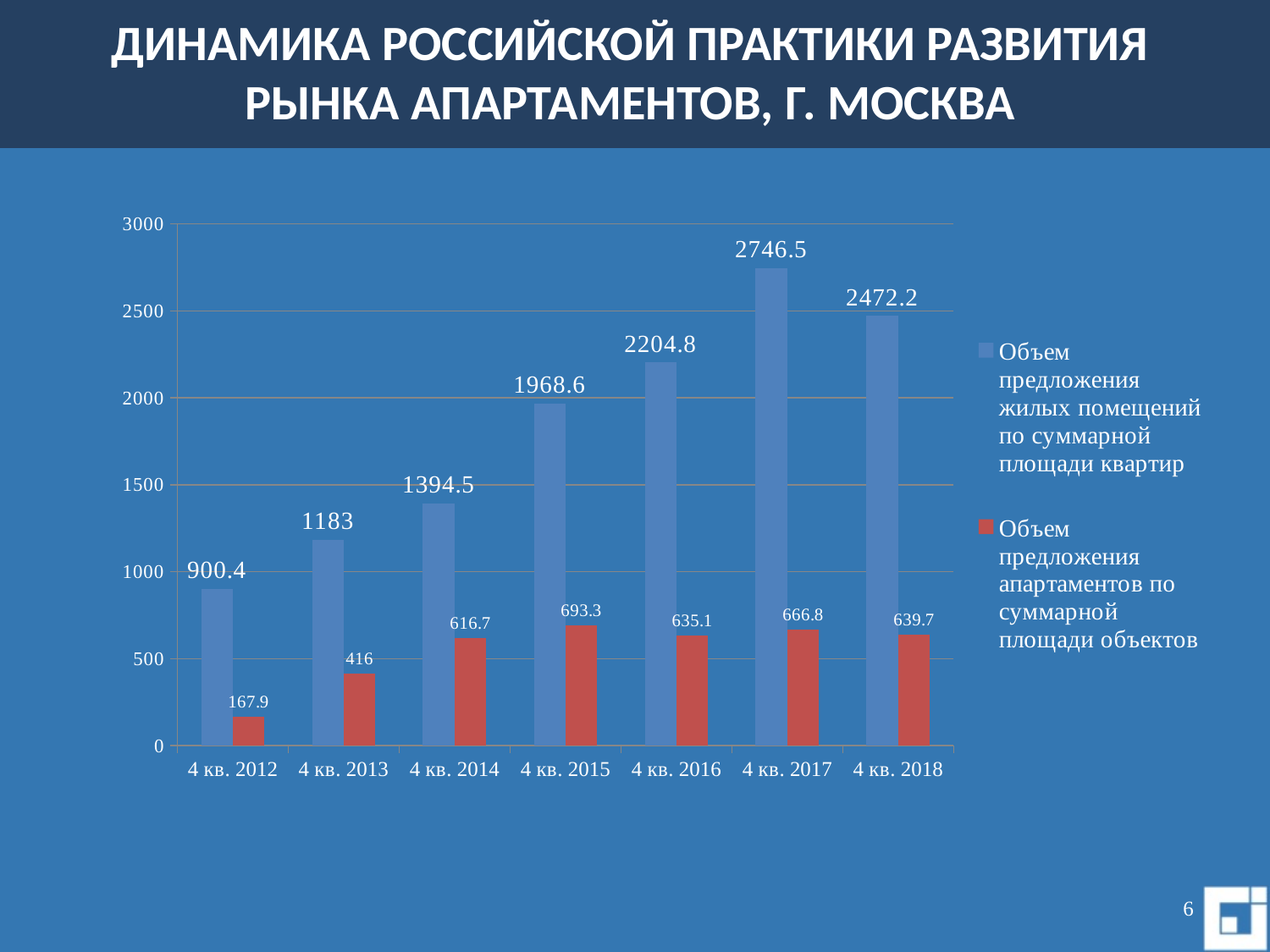
What is the value of the housing supply series for 4 кв. 2014? 1394.5 What kind of chart is shown on the slide? Bar chart Which is larger for the apartments supply series: the value for 4 кв. 2016 or for 4 кв. 2017? 4 кв. 2017 How many series does the legend list? 2 What is the value of the apartments supply series (Объем предложения апартаментов) for 4 кв. 2012? 167.9 What is the value of the housing supply series (Объем предложения жилых помещений) for 4 кв. 2017? 2746.5 How many quarters are shown on the x axis? 7 In which quarter is the apartments supply series (red bars) highest? 4 кв. 2015 What colour are the bars for the apartments supply series (Объем предложения апартаментов)? Red In which quarter is the housing supply series (blue bars) lowest? 4 кв. 2012 What is the difference between the housing supply values for 4 кв. 2017 and 4 кв. 2018? 274.3 Does the housing supply series (blue bars) rise or fall from 4 кв. 2012 to 4 кв. 2017? Rise